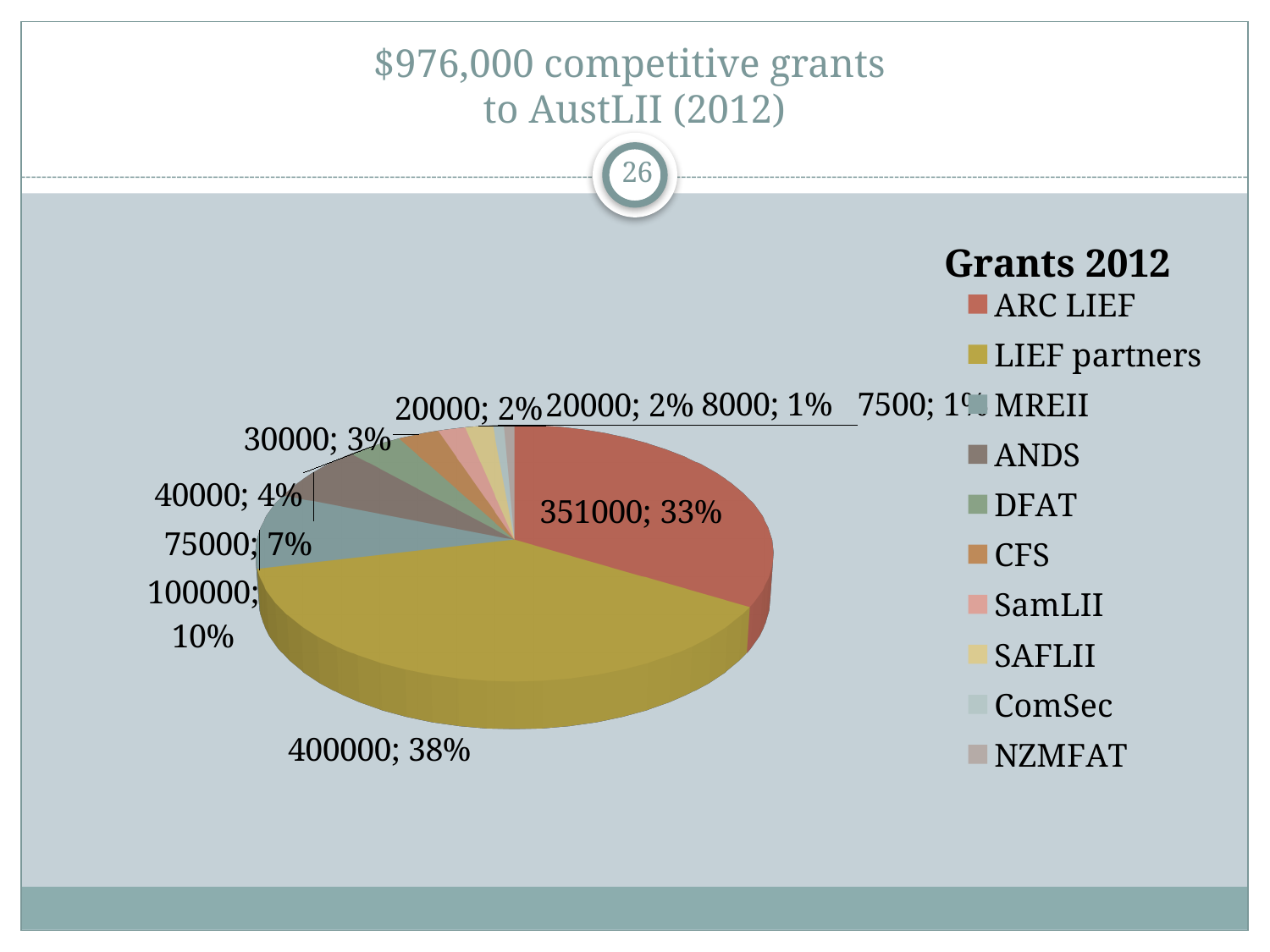
Which is larger, the ARC LIEF slice or the LIEF partners slice? LIEF partners What kind of chart is shown on the slide? pie chart What value is shown for the MREII slice? 100000 How many entries does the chart legend list? 10 What is the title of the chart? Grants 2012 How many slices does the pie chart have? 10 What value is shown for the ARC LIEF slice? 351000 Which category has the smallest slice of the pie? NZMFAT What value is shown for the LIEF partners slice? 400000 What share of the pie does ARC LIEF represent? 33% Which category has the largest slice of the pie? LIEF partners What is the difference between the LIEF partners value and the ARC LIEF value? 49000